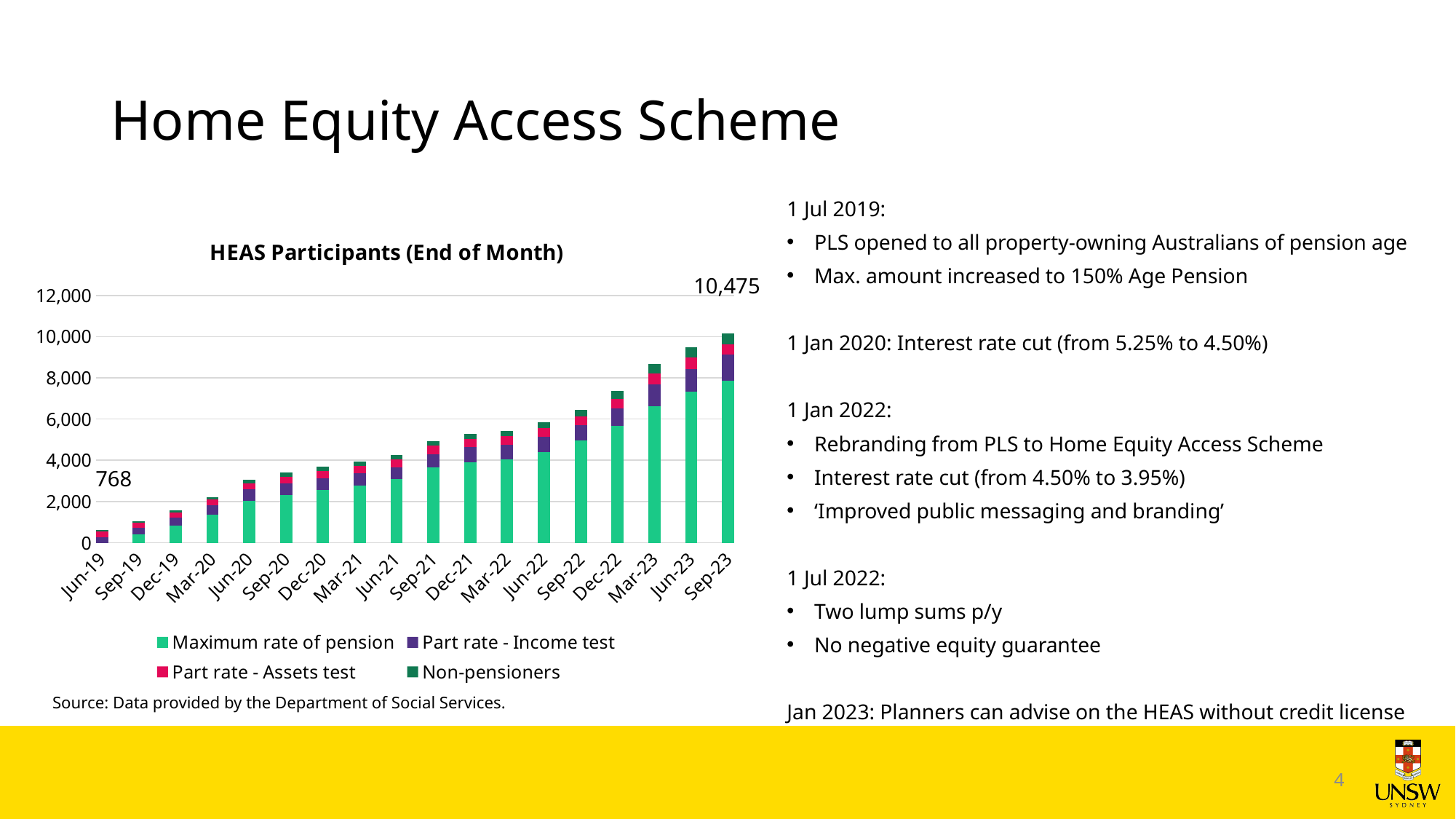
Which month has the highest total number of participants? Sep-23 Which month has the lowest total number of participants? Jun-19 What kind of chart is shown on the slide? Stacked bar chart Do the total participant numbers rise or fall from Jun-19 to Sep-23? Rise What is the total number of HEAS participants shown for Jun-19? 768 What is the total number of HEAS participants shown for Sep-23? 10,475 How many series does the chart legend list? 4 Is the total value for Dec-22 greater or less than 8,000? less Is the total value for Jun-23 greater or less than 8,000? greater What is the title of the chart? HEAS Participants (End of Month) How many months (bars) are shown on the x axis of the chart? 18 What is the difference between the total participants in Sep-23 and in Jun-19? 9,707